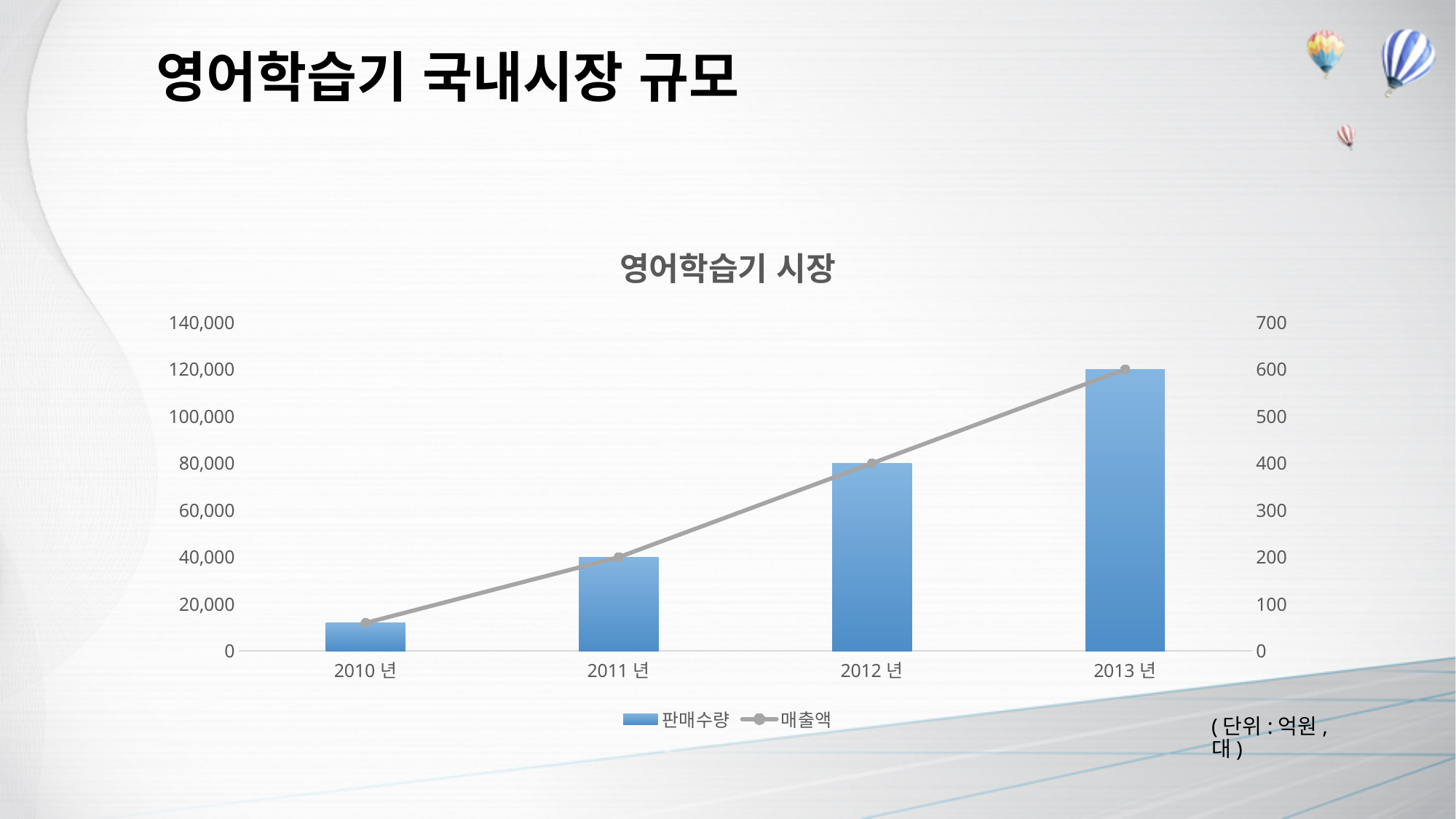
What is the 매출액 value for 2011 년? 200 What is the 매출액 value for 2013 년? 600 How many series does the legend list? 2 Is the 판매수량 value for 2010 년 greater or less than 20,000? less What is the title of the chart? 영어학습기 시장 Which year has the lowest 매출액? 2010 년 What is the 판매수량 value for 2012 년? 80,000 What kind of chart is shown on the slide? A combined bar and line chart What is the 판매수량 value for 2013 년? 120,000 Which year has the highest 판매수량? 2013 년 Do the 매출액 values rise or fall from 2010 년 to 2013 년? rise How many years are shown on the x axis? 4